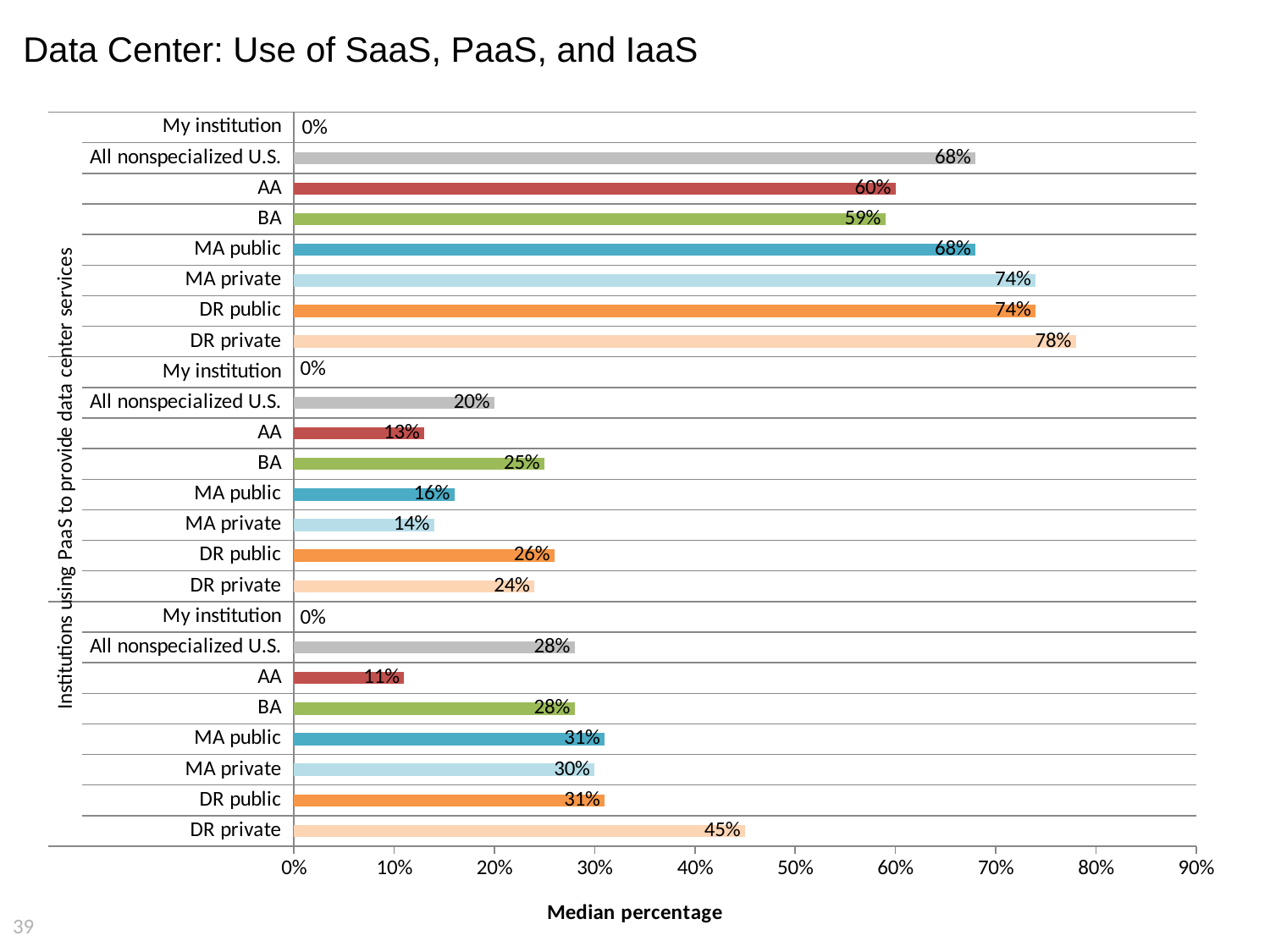
In the top group of bars, what is the difference between DR private and BA? 19% In the top group of bars, what is the value for AA? 60% In the middle group of bars, which category has the lowest non-zero value? AA What type of chart is shown on the slide? bar chart In the bottom group of bars, which category has the highest value? DR private In the top group of bars, which category has the highest value? DR private In the top group of bars, what is the value for DR private? 78% What is the label of the horizontal axis? Median percentage In the middle group of bars, what is the value for BA? 25% In the middle group of bars, what is the difference between DR public and MA private? 12% In the bottom group of bars, which is larger, MA public or AA? MA public In the bottom group of bars, what is the value for DR private? 45%